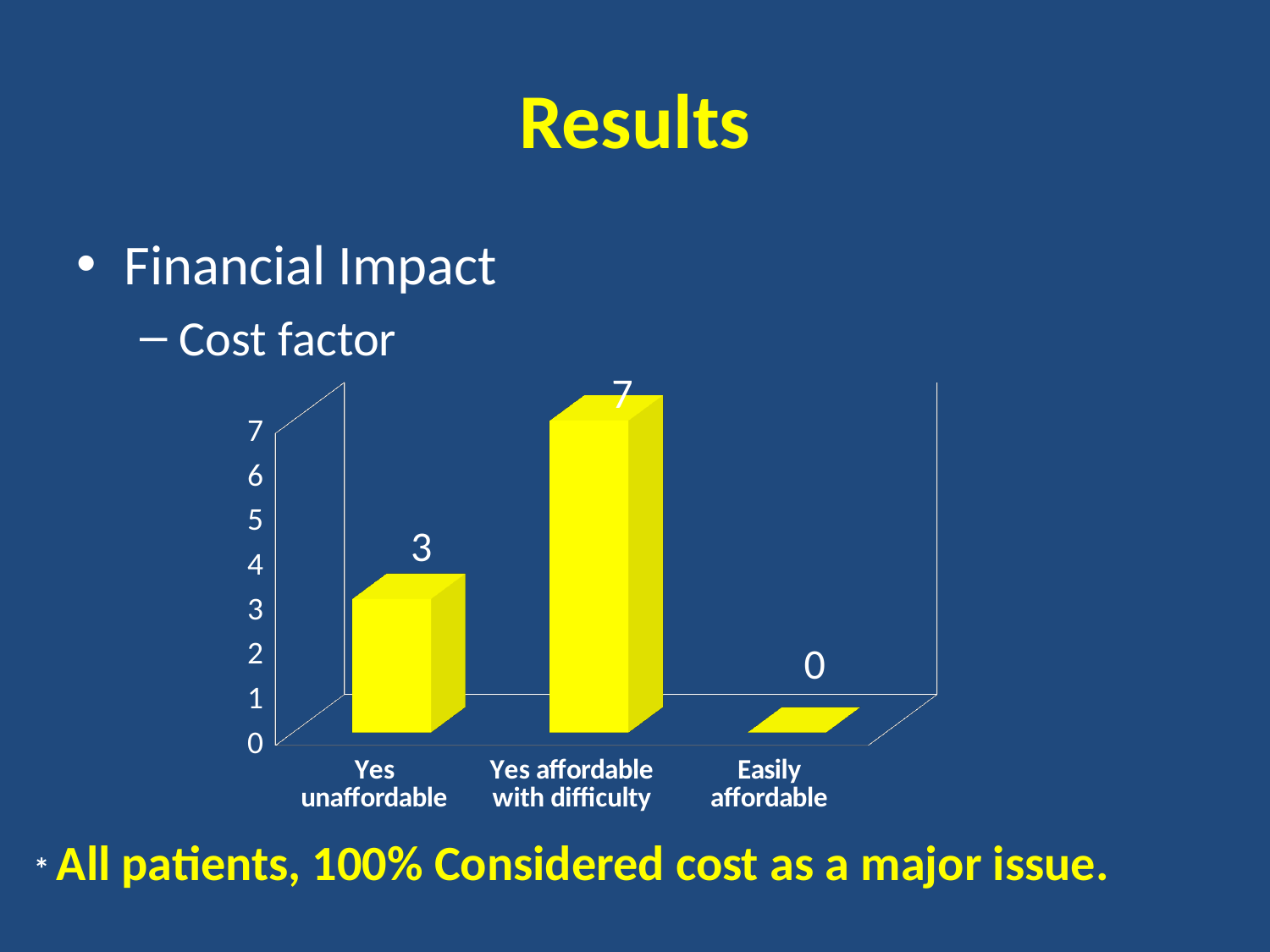
Which category has the lowest value? Easily affordable What is the value for "Yes affordable with difficulty"? 7 What is the difference between the values for "Yes affordable with difficulty" and "Yes unaffordable"? 4 What is the value for "Easily affordable"? 0 What is the total of the three values shown in the chart? 10 Which is larger, the value for "Yes unaffordable" or the value for "Easily affordable"? Yes unaffordable Which category has the highest value? Yes affordable with difficulty What kind of chart is shown on the slide? bar chart Is the value for "Yes affordable with difficulty" greater or less than 5? greater What colour are the bars in the chart? yellow How many categories are shown on the x axis of the chart? 3 What is the value for "Yes unaffordable"? 3